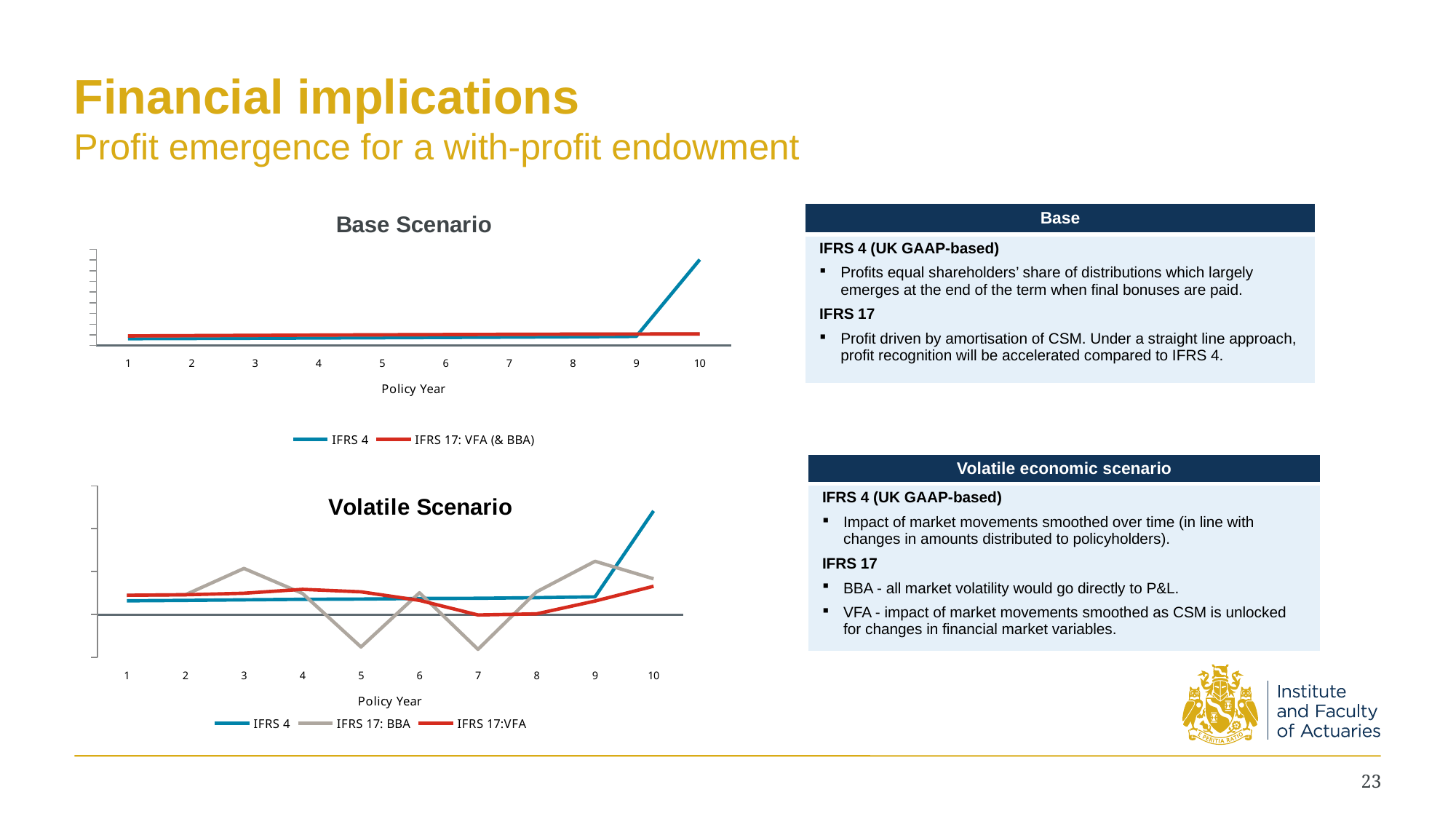
What is the x-axis label on the Base Scenario chart? Policy Year How many series does the legend of the Volatile Scenario chart list? 3 How many policy years are shown on the x axis of the Volatile Scenario chart? 10 In the Base Scenario chart, at policy year 10, which series is higher: IFRS 4 or IFRS 17: VFA (& BBA)? IFRS 4 In the Volatile Scenario chart, which policy year has the highest IFRS 4 value? 10 In the Base Scenario chart, which policy year has the highest IFRS 4 value? 10 In the Volatile Scenario chart, at policy year 10, which series is higher: IFRS 4 or IFRS 17:VFA? IFRS 4 What kind of chart is the Volatile Scenario chart? line chart Which series in the Volatile Scenario chart is drawn in grey? IFRS 17: BBA How many policy years are shown on the x axis of the Base Scenario chart? 10 What kind of chart is the Base Scenario chart? line chart How many series does the legend of the Base Scenario chart list? 2